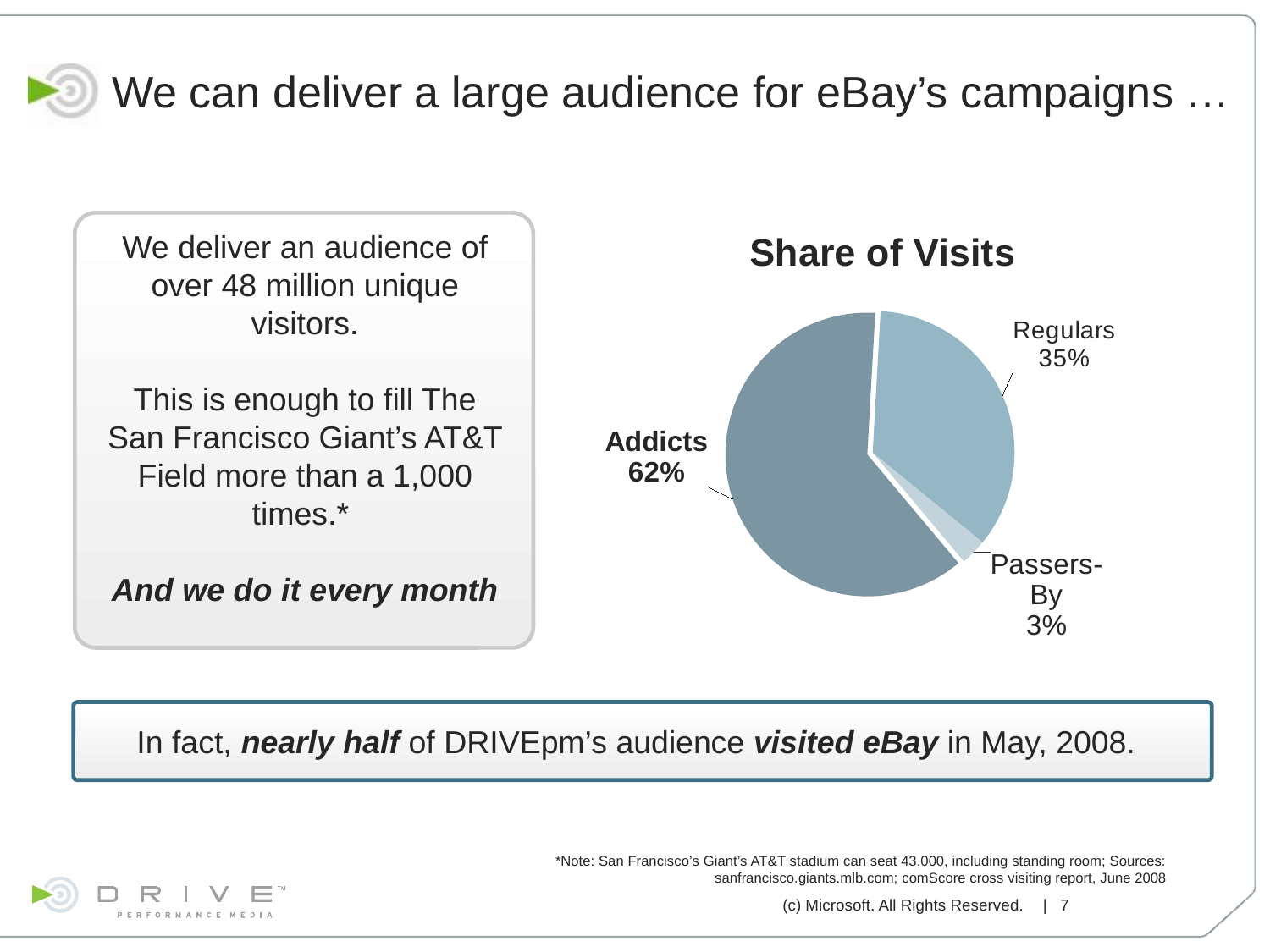
Which category has the largest share of visits? Addicts Is the share of visits for Addicts greater or less than 50%? greater What share of visits do Addicts account for? 62% What kind of chart is shown on the slide? pie chart What is the title of the pie chart? Share of Visits What share of visits do Passers-By account for? 3% What is the difference in share of visits between Addicts and Regulars? 27% What is the combined share of visits for Regulars and Passers-By? 38% Which has a larger share of visits, Regulars or Passers-By? Regulars What share of visits do Regulars account for? 35% How many categories are shown in the pie chart? 3 Which category has the smallest share of visits? Passers-By